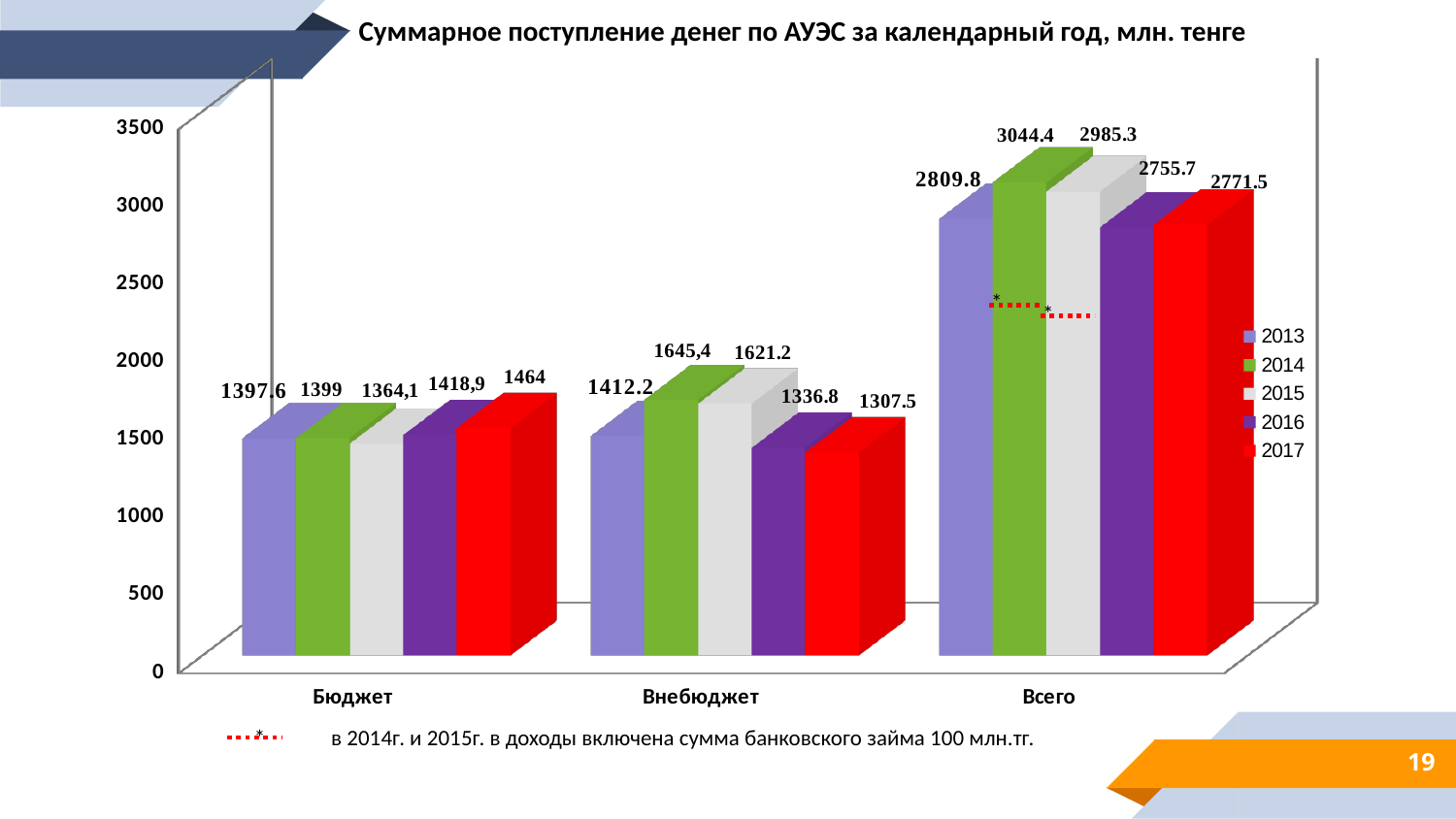
What is the value for 2017 in the Бюджет category? 1464 What is the value for 2014 in the Всего category? 3044.4 What is the value for 2016 in the Внебюджет category? 1336.8 Which year has the lowest value in the Внебюджет category? 2017 What is the difference between the 2014 and 2013 values in the Всего category? 234.6 What kind of chart is shown on the slide? bar chart Is the value for 2016 in the Всего category greater or less than 2500? greater Which year has the highest value in the Всего category? 2014 How many categories are shown on the x axis? 3 What is the value for 2013 in the Внебюджет category? 1412.2 Which is larger in the Внебюджет category: the value for 2014 or the value for 2015? 2014 How many series does the legend list? 5